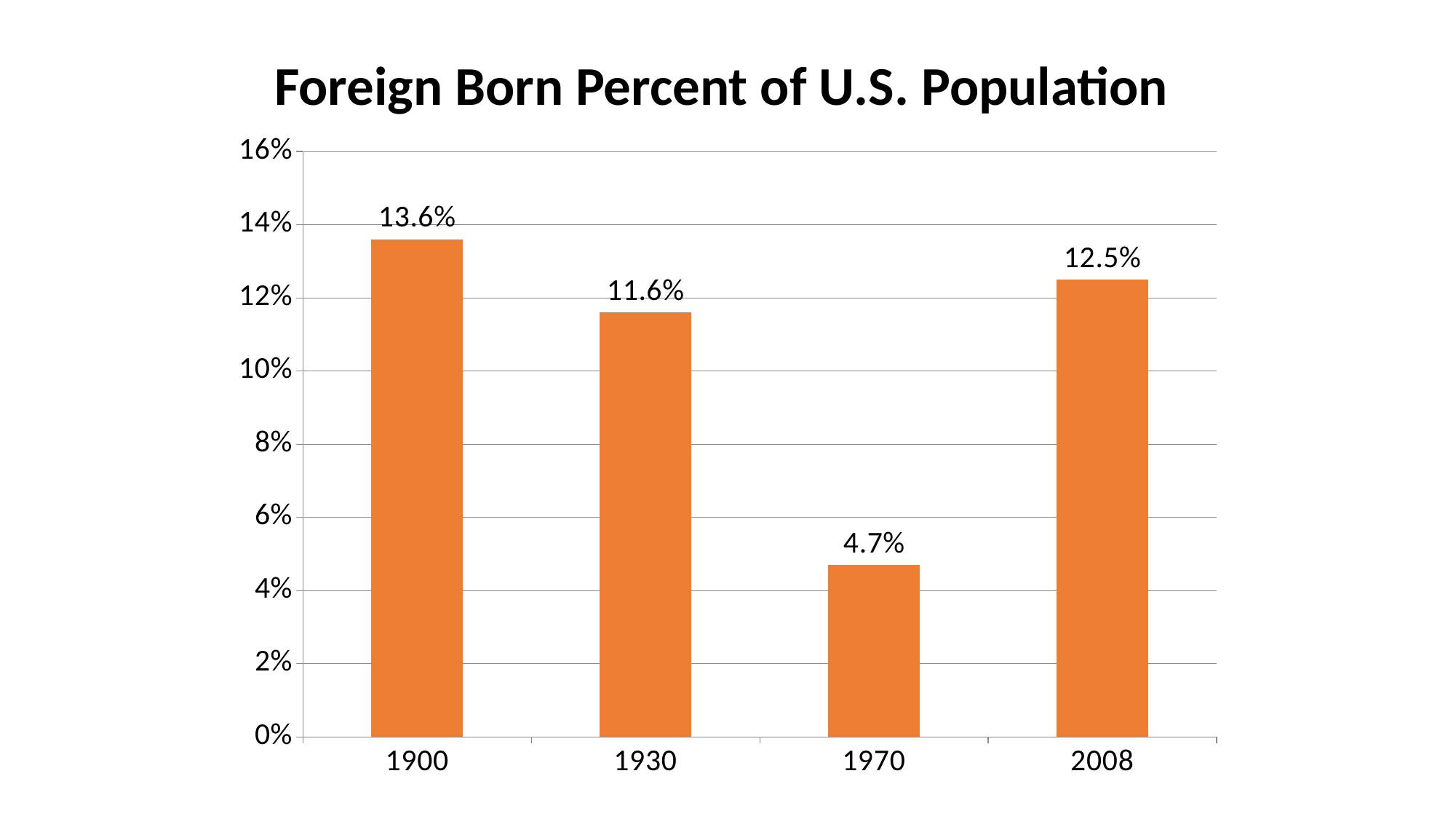
Is the value for 1970 greater or less than 6%? less What is the title of the chart? Foreign Born Percent of U.S. Population Which year has a larger foreign born percent, 1930 or 2008? 2008 What is the foreign born percent of the U.S. population in 1970? 4.7% What is the foreign born percent of the U.S. population in 1900? 13.6% What is the foreign born percent of the U.S. population in 2008? 12.5% What is the difference between the foreign born percent in 2008 and in 1970? 7.8% Which year has the highest foreign born percent? 1900 What is the difference between the foreign born percent in 1900 and in 1930? 2.0% Which year has the lowest foreign born percent? 1970 How many years are shown on the chart? 4 What kind of chart is shown on the slide? Bar chart